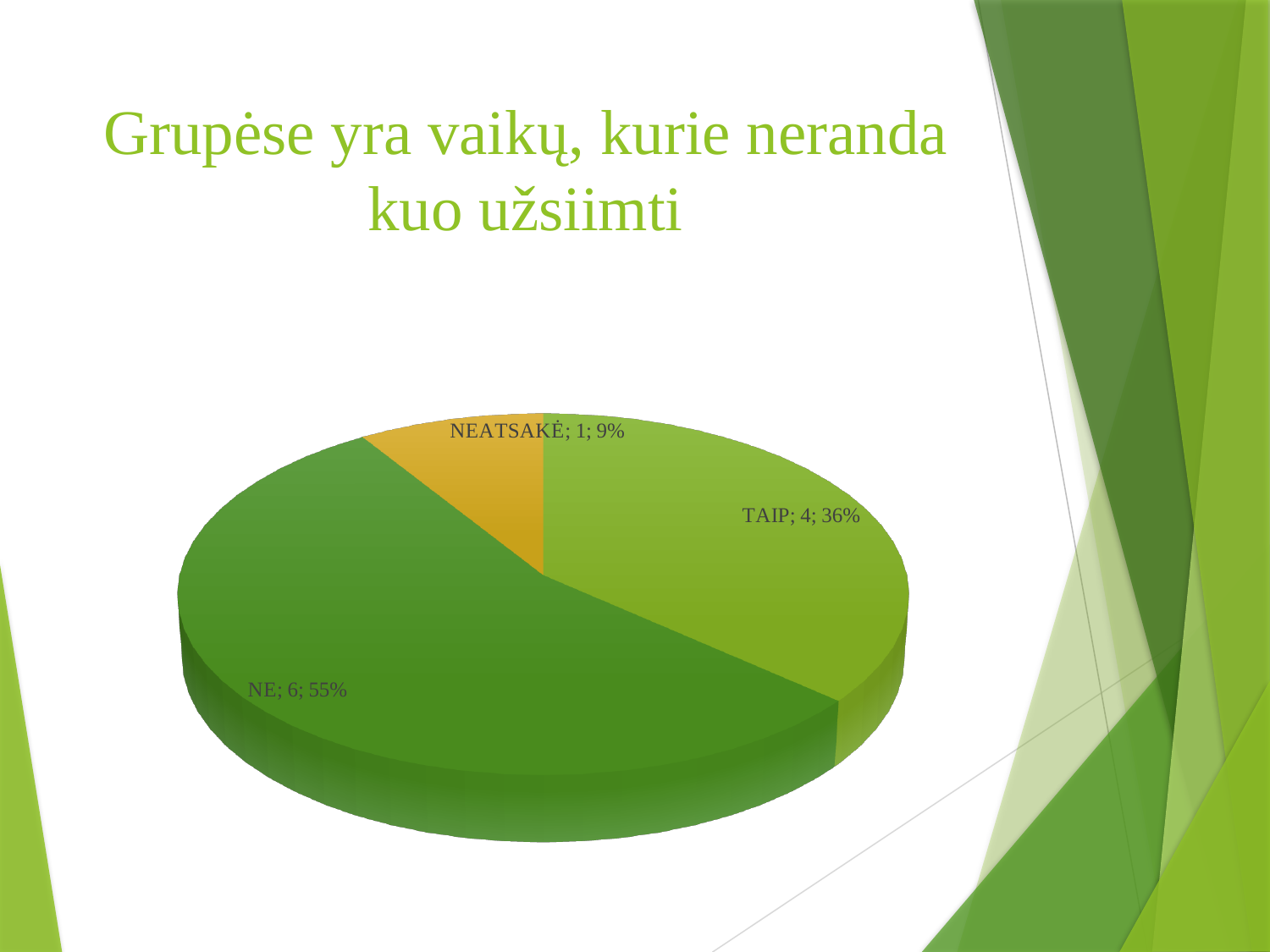
What is the count for NE? 6 Which is larger, the count for TAIP or the count for NEATSAKĖ? TAIP What is the count for TAIP? 4 What share of the pie does TAIP take? 36% What kind of chart is shown on the slide? pie chart How many slices does the pie chart have? 3 Which category has the largest slice? NE Which category has the smallest slice? NEATSAKĖ What share of the pie does NE take? 55% What is the difference between the counts for NE and TAIP? 2 What is the count for NEATSAKĖ? 1 What share of the pie does NEATSAKĖ take? 9%